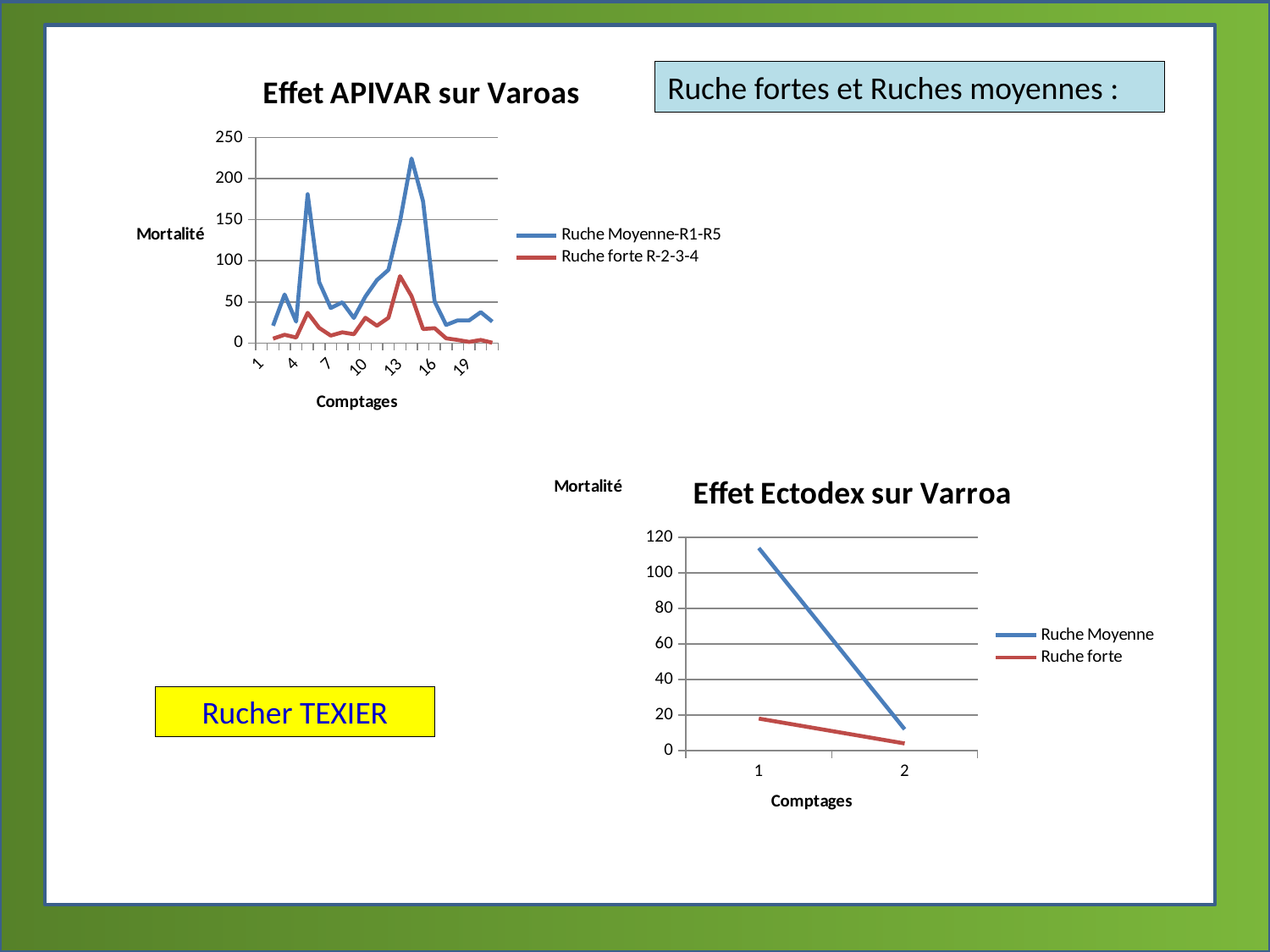
How many series does the legend of "Effet Ectodex sur Varroa" list? 2 In "Effet APIVAR sur Varoas", is the highest value of Ruche Moyenne-R1-R5 greater or less than 200? greater In "Effet APIVAR sur Varoas", which series reaches the higher peak, Ruche Moyenne-R1-R5 or Ruche forte R-2-3-4? Ruche Moyenne-R1-R5 In "Effet APIVAR sur Varoas", what is the label of the x axis? Comptages How many comptages (x-axis points) are shown in "Effet Ectodex sur Varroa"? 2 What type of chart is "Effet APIVAR sur Varoas"? line chart In "Effet APIVAR sur Varoas", is the highest value of Ruche forte R-2-3-4 greater or less than 100? less How many series does the legend of "Effet APIVAR sur Varoas" list? 2 What type of chart is "Effet Ectodex sur Varroa"? line chart In "Effet Ectodex sur Varroa", do the values for Ruche Moyenne rise or fall from comptage 1 to comptage 2? fall In "Effet Ectodex sur Varroa", is the value for Ruche Moyenne at comptage 1 greater or less than 100? greater